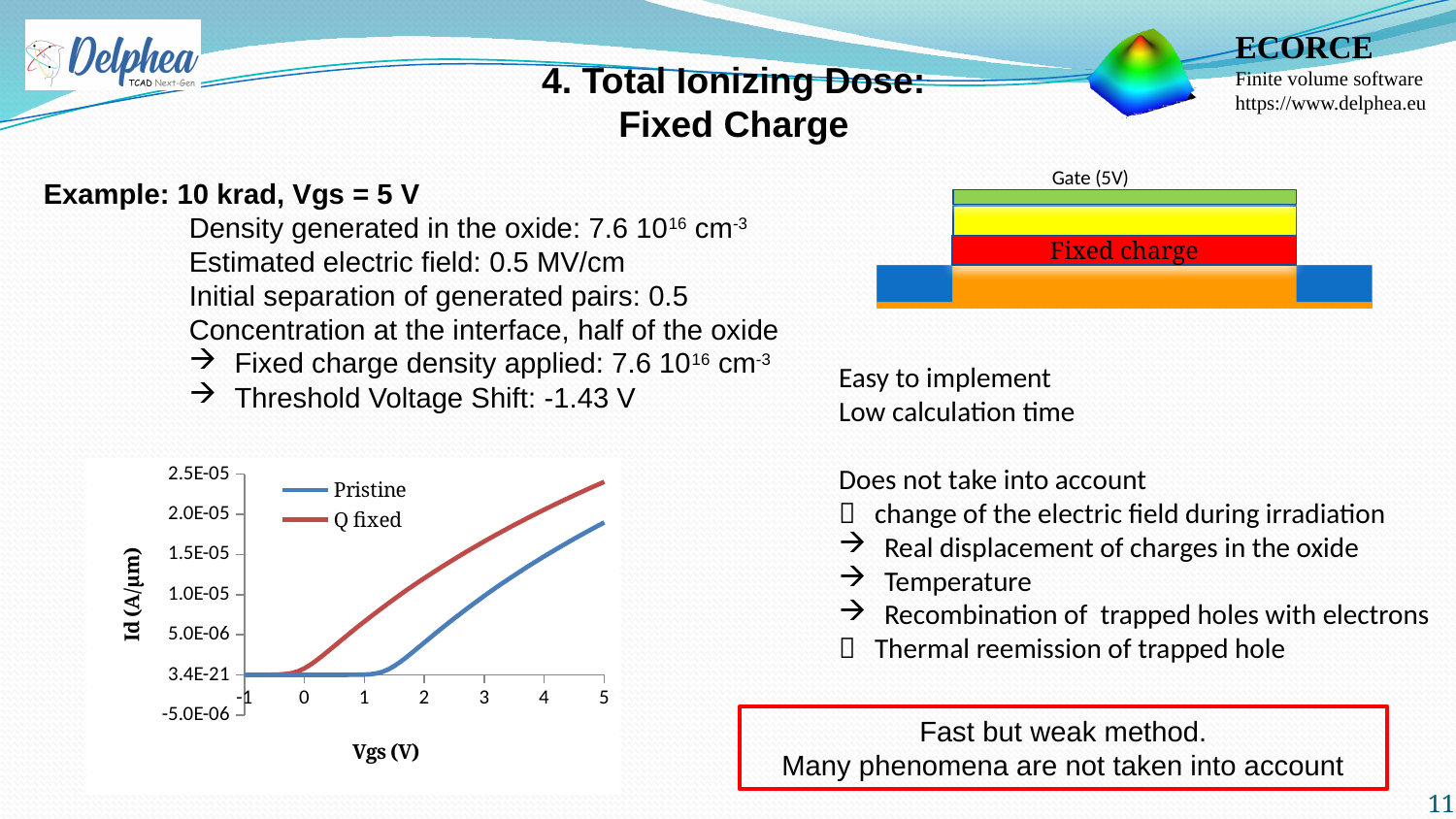
Does the Id value of the Q fixed series rise or fall as Vgs increases from 0 V to 5 V? rise What are the two series named in the chart legend? Pristine and Q fixed What kind of chart is shown on the slide? line chart Is the Id value of the Pristine series at Vgs = 5 V greater or less than 1.5E-05? greater Is the Id value of the Pristine series at Vgs = 2 V greater or less than 1.0E-05? less Is the Id value of the Q fixed series at Vgs = 5 V greater or less than 2.0E-05? greater How many series does the chart legend list? 2 What is the highest value shown on the chart's y axis? 2.5E-05 What is the label of the chart's x axis? Vgs (V) Which series starts rising at a lower Vgs, Pristine or Q fixed? Q fixed At Vgs = 5 V, which series has the larger Id value, Pristine or Q fixed? Q fixed